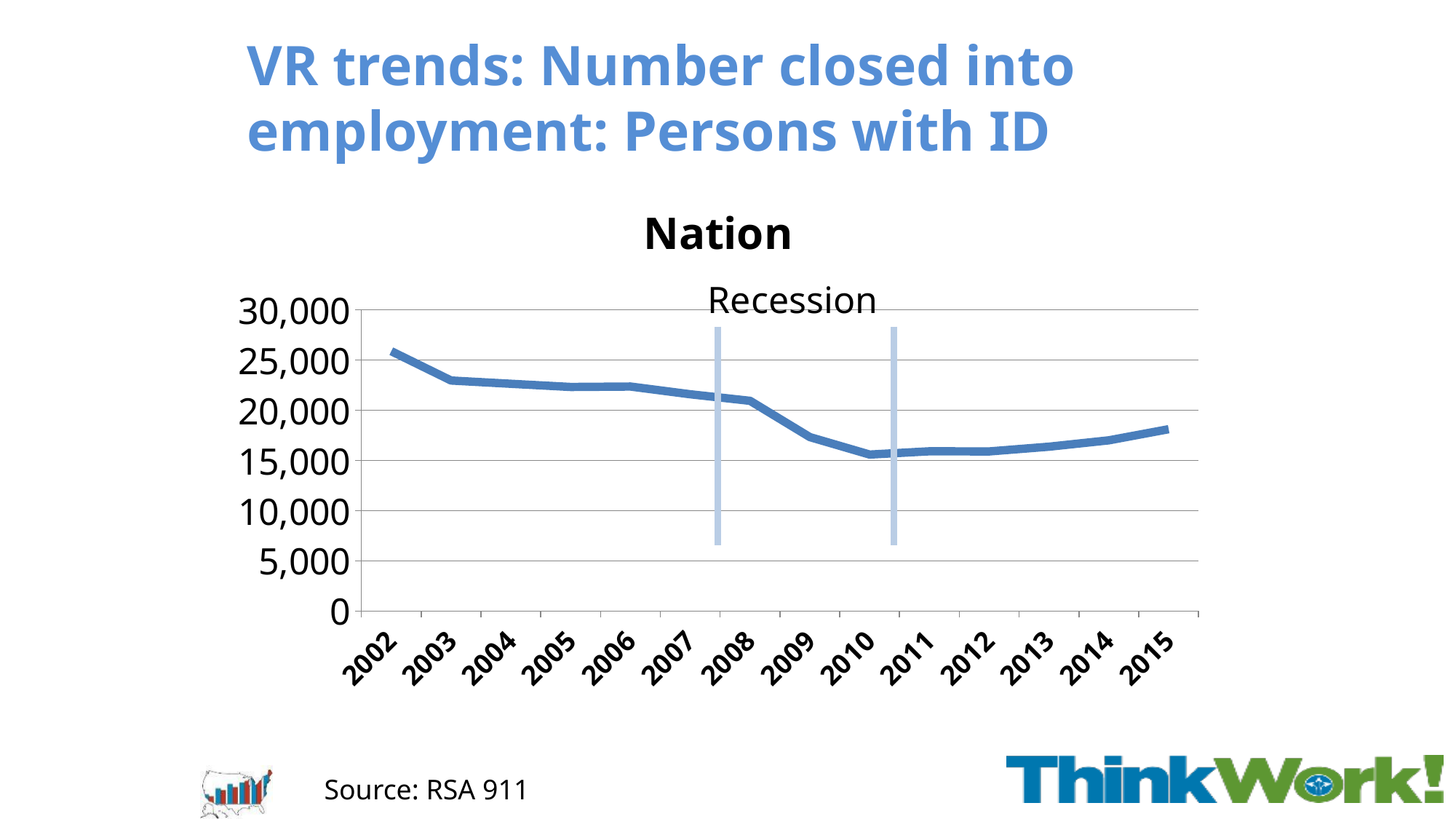
Is the value for 2015 greater or less than 20,000? less How many years are plotted along the x axis of the chart? 14 What kind of chart is shown on the slide? Line chart Which year has a larger value, 2002 or 2015? 2002 Is the value for 2009 greater or less than 20,000? less Which year has the highest number closed into employment? 2002 Which year has a larger value, 2010 or 2015? 2015 Do the values rise or fall from 2002 to 2010? Fall Is the value for 2002 greater or less than 25,000? greater What is the title of the chart? Nation Which year has the lowest number closed into employment? 2010